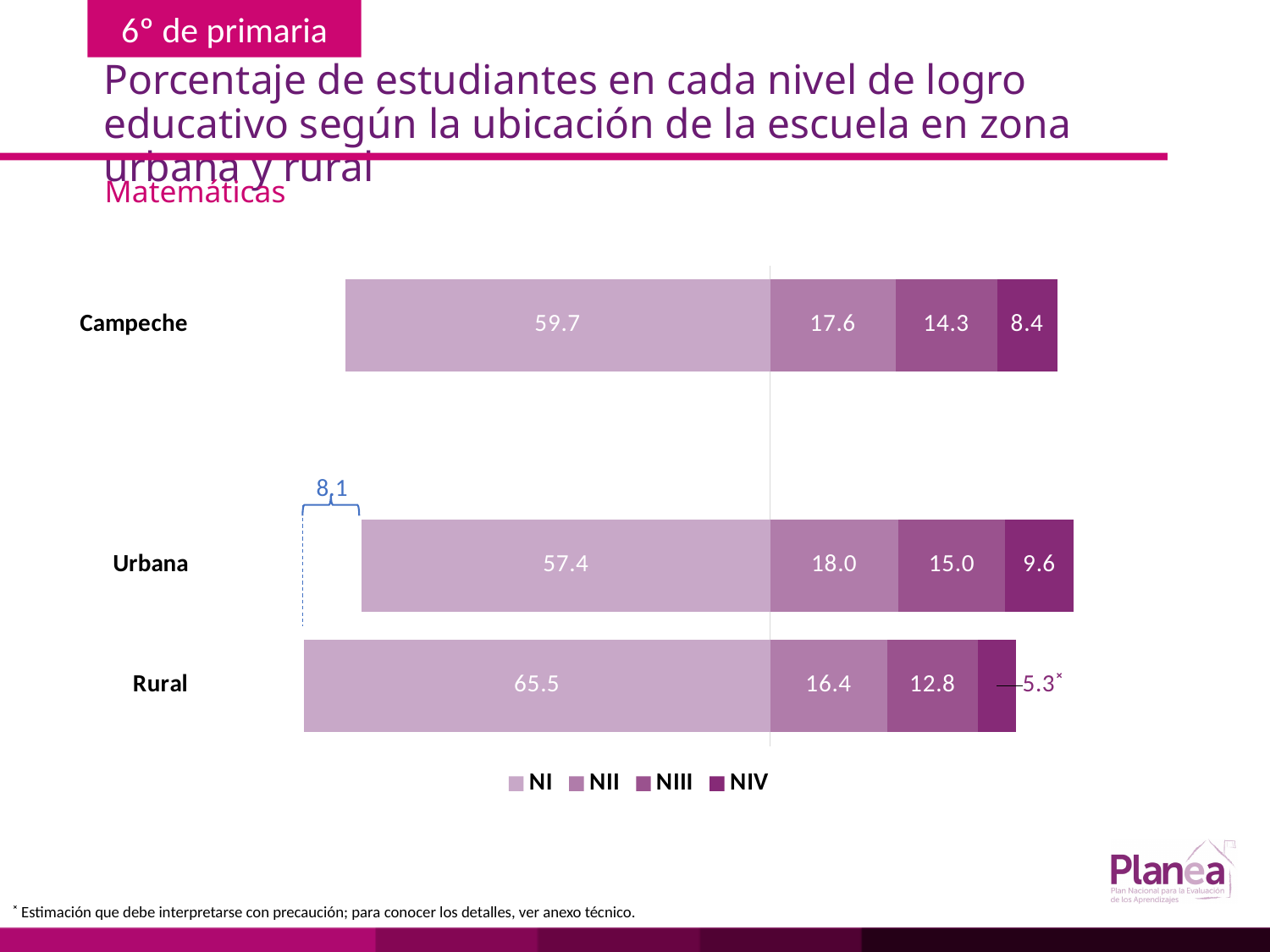
How many categories are shown in the chart? 3 How many series does the legend list? 4 What is the total of the stacked bar for Campeche? 100.0 What is the NII value for Campeche? 17.6 Which category has the highest NI value? Rural Which is larger, the NIII value for Urbana or the NIII value for Campeche? Urbana What kind of chart is shown on the slide? Stacked bar chart Which category has the lowest NIV value? Rural What is the NIV value for Urbana? 9.6 What is the NI value for Rural? 65.5 What is the NIII value for Rural? 12.8 What is the difference between the NI values for Rural and Urbana? 8.1